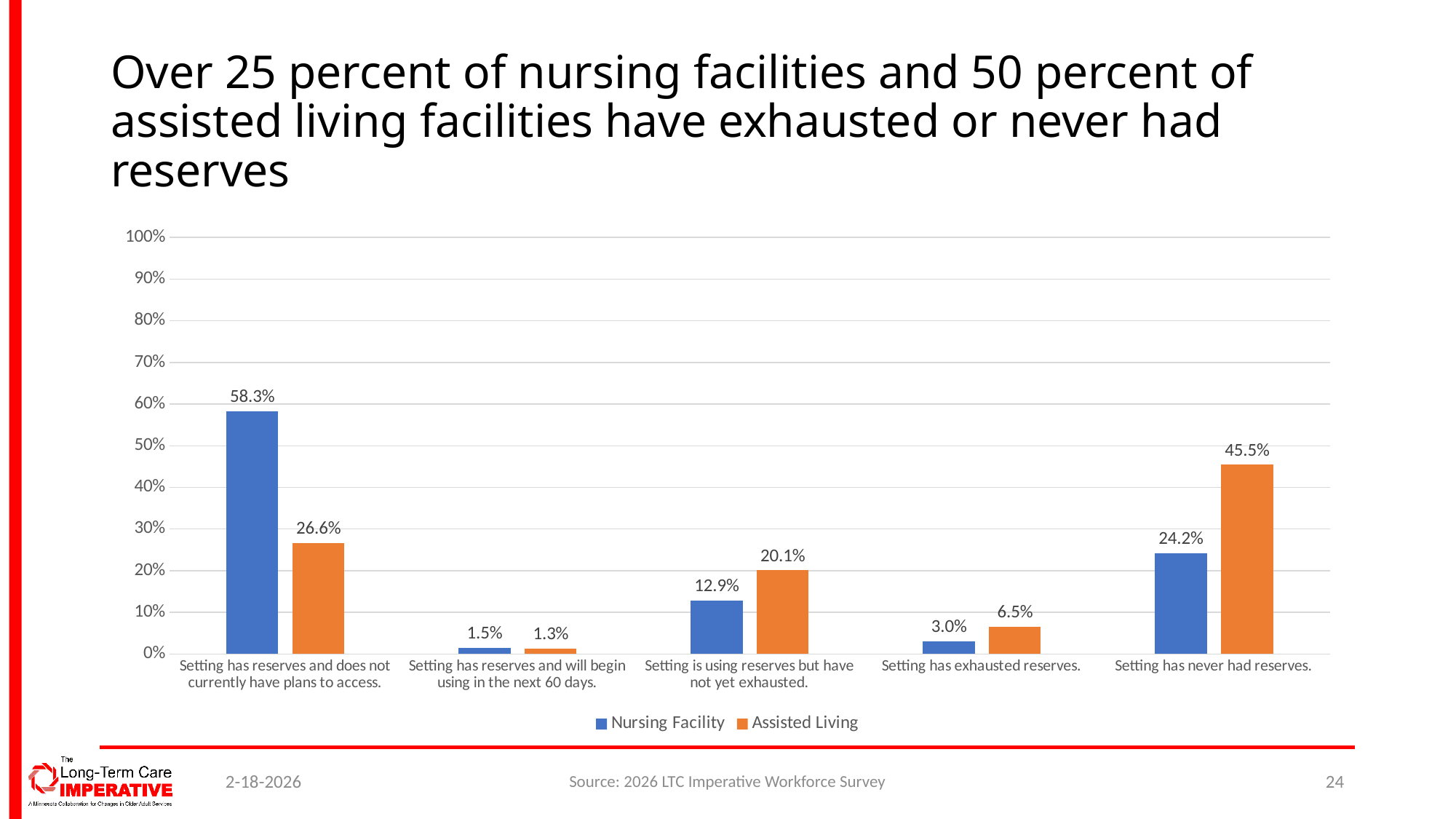
How many categories are shown on the x axis? 5 What is the Nursing Facility value for "Setting has reserves and does not currently have plans to access."? 58.3% How many series does the legend list? 2 Which colour represents the Assisted Living series? Orange What is the difference between the Nursing Facility and Assisted Living values for "Setting has reserves and does not currently have plans to access."? 31.7% What kind of chart is shown on the slide? Bar chart Which series has the larger value for "Setting has never had reserves."? Assisted Living Which category has the lowest Assisted Living value? Setting has reserves and will begin using in the next 60 days. What is the Assisted Living value for "Setting has never had reserves."? 45.5% What is the Assisted Living value for "Setting is using reserves but have not yet exhausted."? 20.1% What is the Nursing Facility value for "Setting has exhausted reserves."? 3.0% Which category has the highest Nursing Facility value? Setting has reserves and does not currently have plans to access.